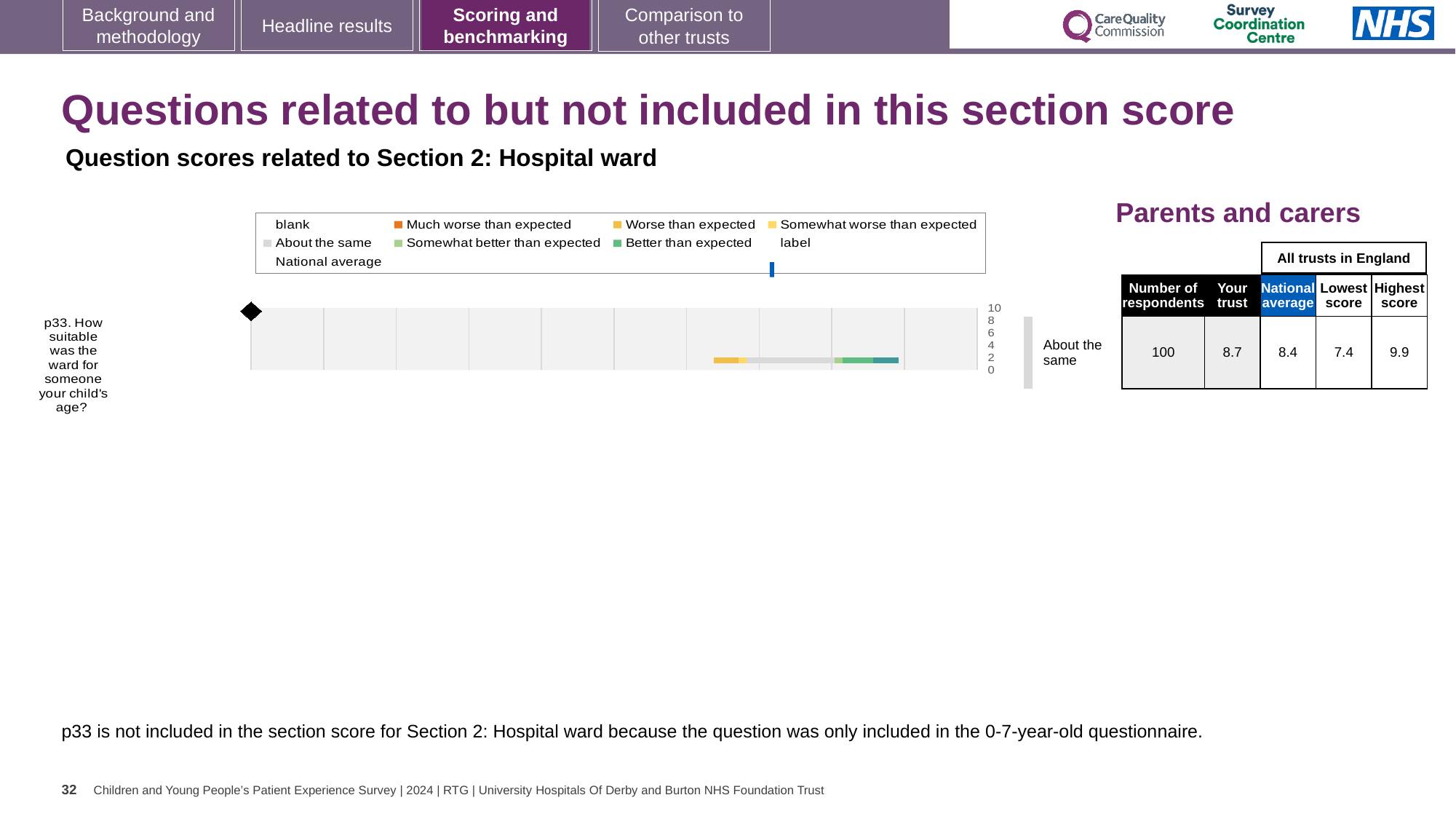
What is the number of respondents for p33? 100 What is the lowest score among all trusts in England for p33? 7.4 What kind of chart is shown for question p33? bar chart What is the highest score among all trusts in England for p33? 9.9 What is the 'Your trust' score for p33? 8.7 What is the highest value shown on the chart's axis? 10 Which is larger for p33, the 'Your trust' score or the national average? Your trust What is the national average score for p33? 8.4 Which respondent group does the chart relate to, according to the heading above the table? Parents and carers How many questions are plotted in the chart? 1 What benchmark category label is shown next to the bar for p33? About the same What is the difference between the highest score and the lowest score for p33? 2.5